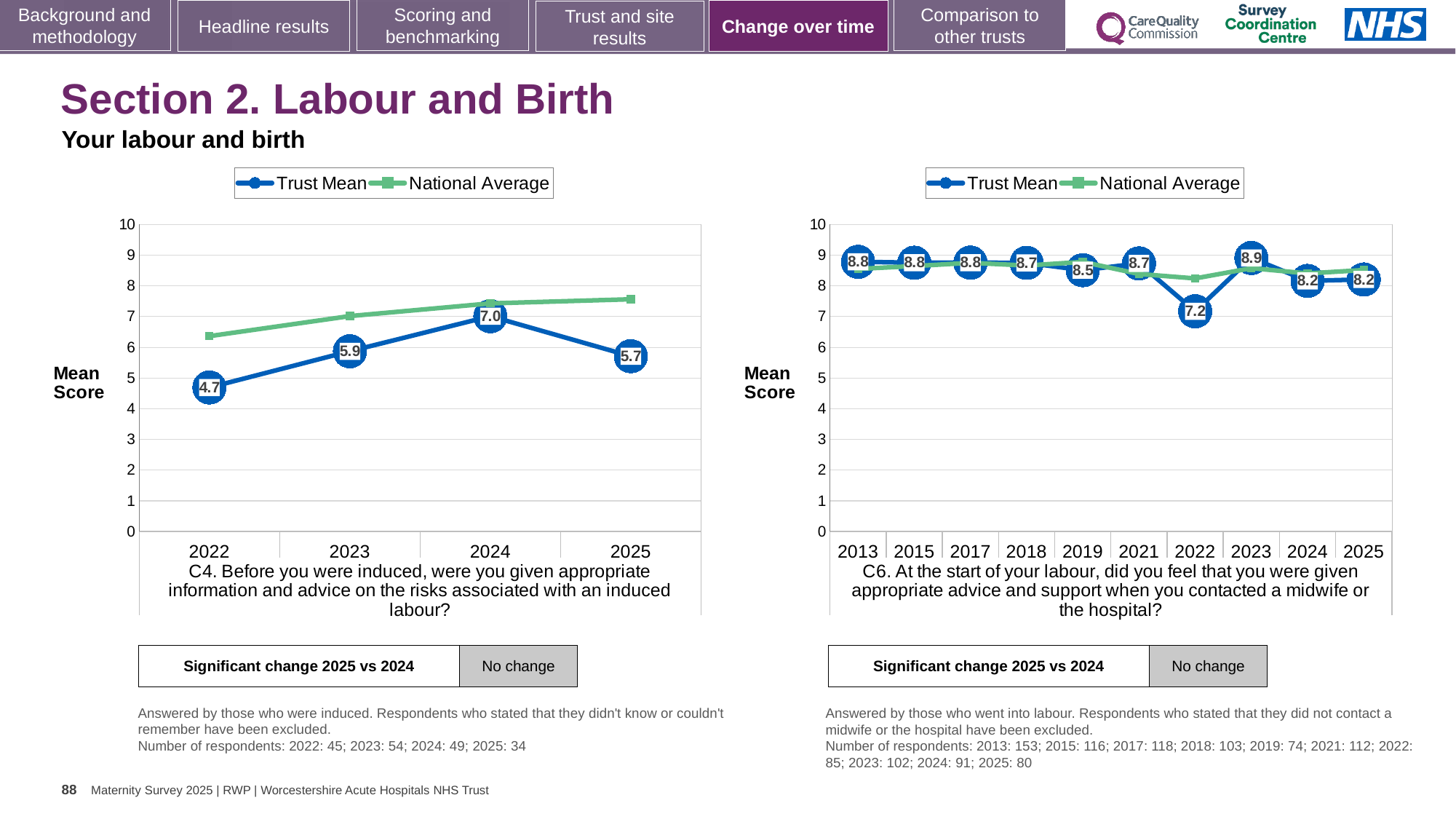
In the C4 chart on the left, what is the Trust Mean score for 2024? 7.0 In the C4 chart on the left, which year has the highest Trust Mean score? 2024 How many years are plotted on the x axis of the C6 chart on the right? 10 How many series does the legend of the C4 chart on the left list? 2 In the C6 chart on the right, what is the Trust Mean score for 2022? 7.2 In the C6 chart on the right, which year has the highest Trust Mean score? 2023 In the C4 chart on the left, is the National Average for 2022 greater or less than 6? greater In the C4 chart on the left, what is the Trust Mean score for 2022? 4.7 What type of chart is the C6 chart on the right? Line chart In the C6 chart on the right, which year has the lowest Trust Mean score? 2022 In the C4 chart on the left, which year has the lowest Trust Mean score? 2022 In the C4 chart on the left, what is the difference between the Trust Mean scores for 2024 and 2025? 1.3